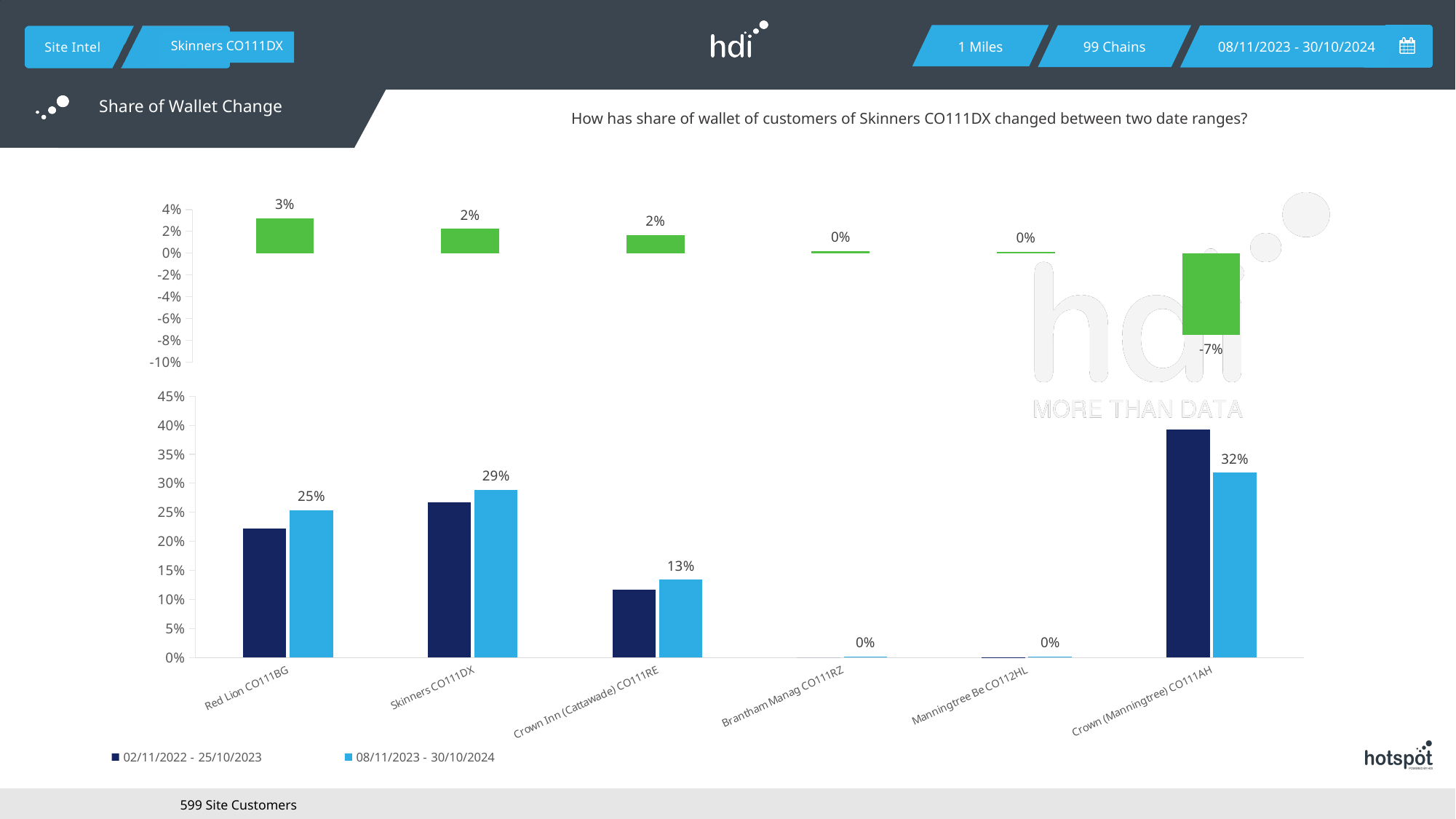
In the bottom chart, how many series does the legend list? 2 In the bottom chart, what is the value for Skinners CO111DX in the 08/11/2023 - 30/10/2024 series? 29% In the top chart (share of wallet change), what is the value for Red Lion CO111BG? 3% What kind of chart is the bottom chart? bar chart In the bottom chart, which category has the highest value in the 08/11/2023 - 30/10/2024 series? Crown (Manningtree) CO111AH In the top chart (share of wallet change), what is the difference between the values for Red Lion CO111BG and Skinners CO111DX? 1 percentage point In the bottom chart, which is larger in the 08/11/2023 - 30/10/2024 series: Red Lion CO111BG or Crown Inn (Cattawade) CO111RE? Red Lion CO111BG In the top chart (share of wallet change), which category has the lowest value? Crown (Manningtree) CO111AH In the bottom chart, is the value for Crown (Manningtree) CO111AH in the 02/11/2022 - 25/10/2023 series greater or less than 35%? greater In the bottom chart, what is the difference between Crown (Manningtree) CO111AH and Skinners CO111DX in the 08/11/2023 - 30/10/2024 series? 3 percentage points In the top chart (share of wallet change), what is the value for Crown (Manningtree) CO111AH? -7% In the top chart (share of wallet change), how many categories are plotted? 6